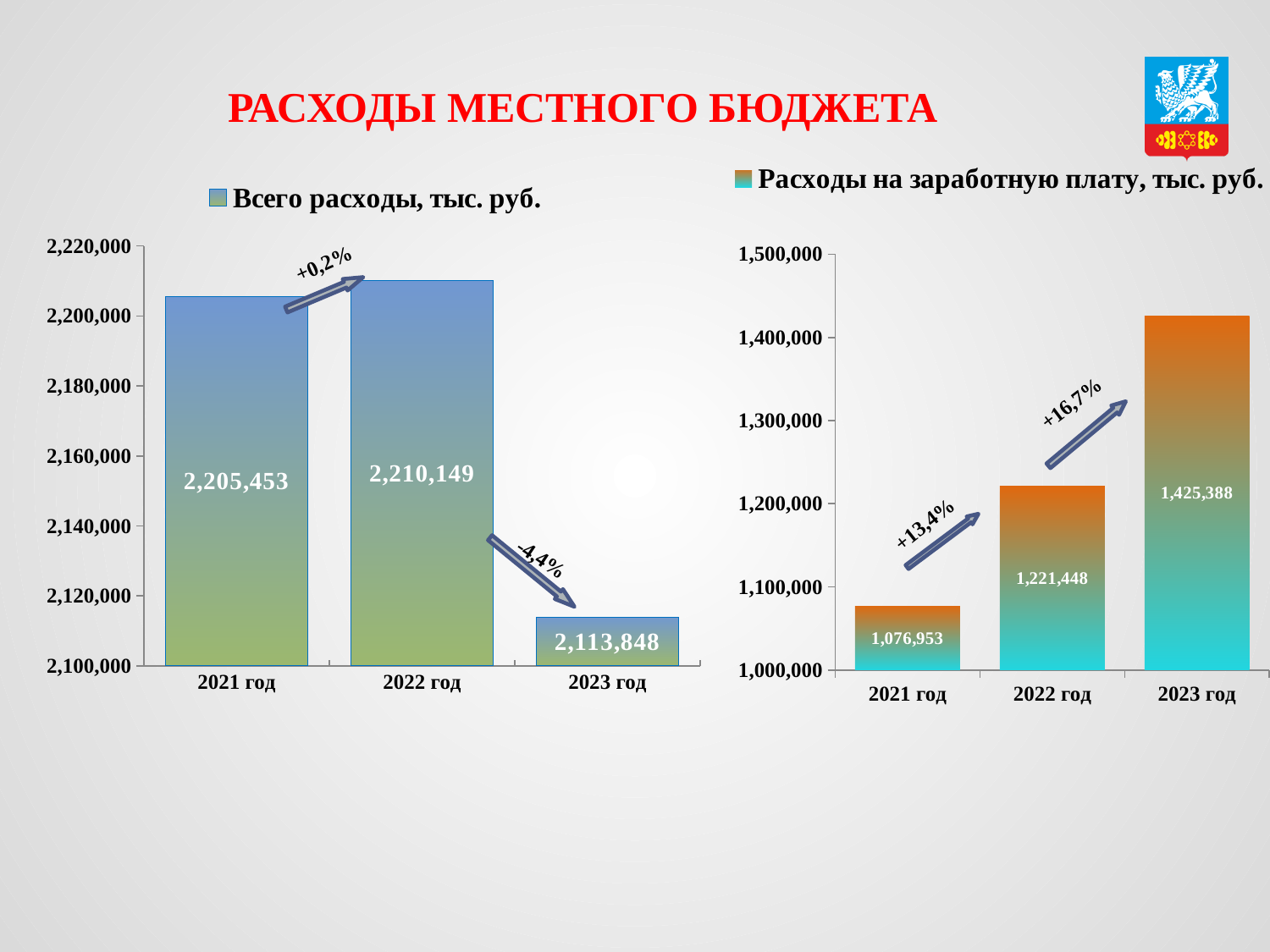
In the chart titled "Всего расходы, тыс. руб.", what is the value for 2022 год? 2,210,149 What kind of chart is the chart titled "Всего расходы, тыс. руб."? bar chart In the chart titled "Всего расходы, тыс. руб.", what is the difference between the 2022 год and 2023 год values? 96,301 In the chart titled "Всего расходы, тыс. руб.", which year has the lowest value? 2023 год In the chart titled "Расходы на заработную плату, тыс. руб.", what is the difference between the 2022 год and 2021 год values? 144,495 In the chart titled "Расходы на заработную плату, тыс. руб.", which year has the highest value? 2023 год In the chart titled "Всего расходы, тыс. руб.", what is the value for 2023 год? 2,113,848 In the chart titled "Расходы на заработную плату, тыс. руб.", how many years are plotted? 3 In the chart titled "Расходы на заработную плату, тыс. руб.", what is the value for 2023 год? 1,425,388 In the chart titled "Расходы на заработную плату, тыс. руб.", what is the value for 2021 год? 1,076,953 In the chart titled "Всего расходы, тыс. руб.", what percentage change is shown between 2022 год and 2023 год? -4,4% In the chart titled "Расходы на заработную плату, тыс. руб.", do the values rise or fall from 2021 год to 2023 год? rise